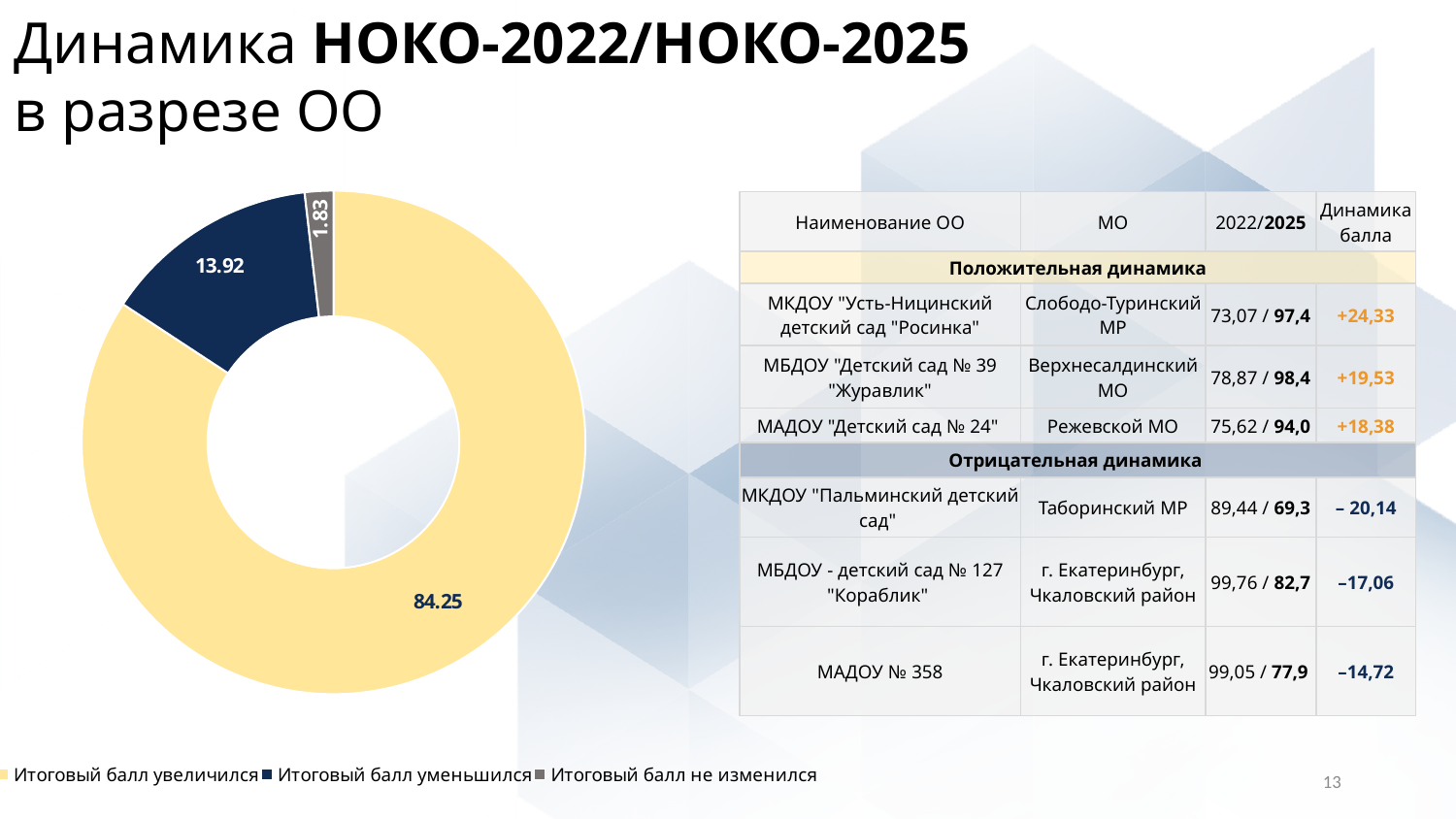
How many slices does the doughnut chart have? 3 What is the difference between the values for "Итоговый балл уменьшился" and "Итоговый балл не изменился"? 12.09 How many entries does the legend of the doughnut chart list? 3 What is the value for "Итоговый балл уменьшился" in the doughnut chart? 13.92 Which category has the smallest slice in the doughnut chart? Итоговый балл не изменился What colour is the slice for "Итоговый балл уменьшился" in the doughnut chart? Dark blue Which is larger in the doughnut chart: "Итоговый балл уменьшился" or "Итоговый балл не изменился"? Итоговый балл уменьшился What kind of chart is shown on the slide? Doughnut chart What is the difference between the values for "Итоговый балл увеличился" and "Итоговый балл уменьшился"? 70.33 Which category has the largest slice in the doughnut chart? Итоговый балл увеличился What is the value for "Итоговый балл не изменился" in the doughnut chart? 1.83 What is the value for "Итоговый балл увеличился" in the doughnut chart? 84.25